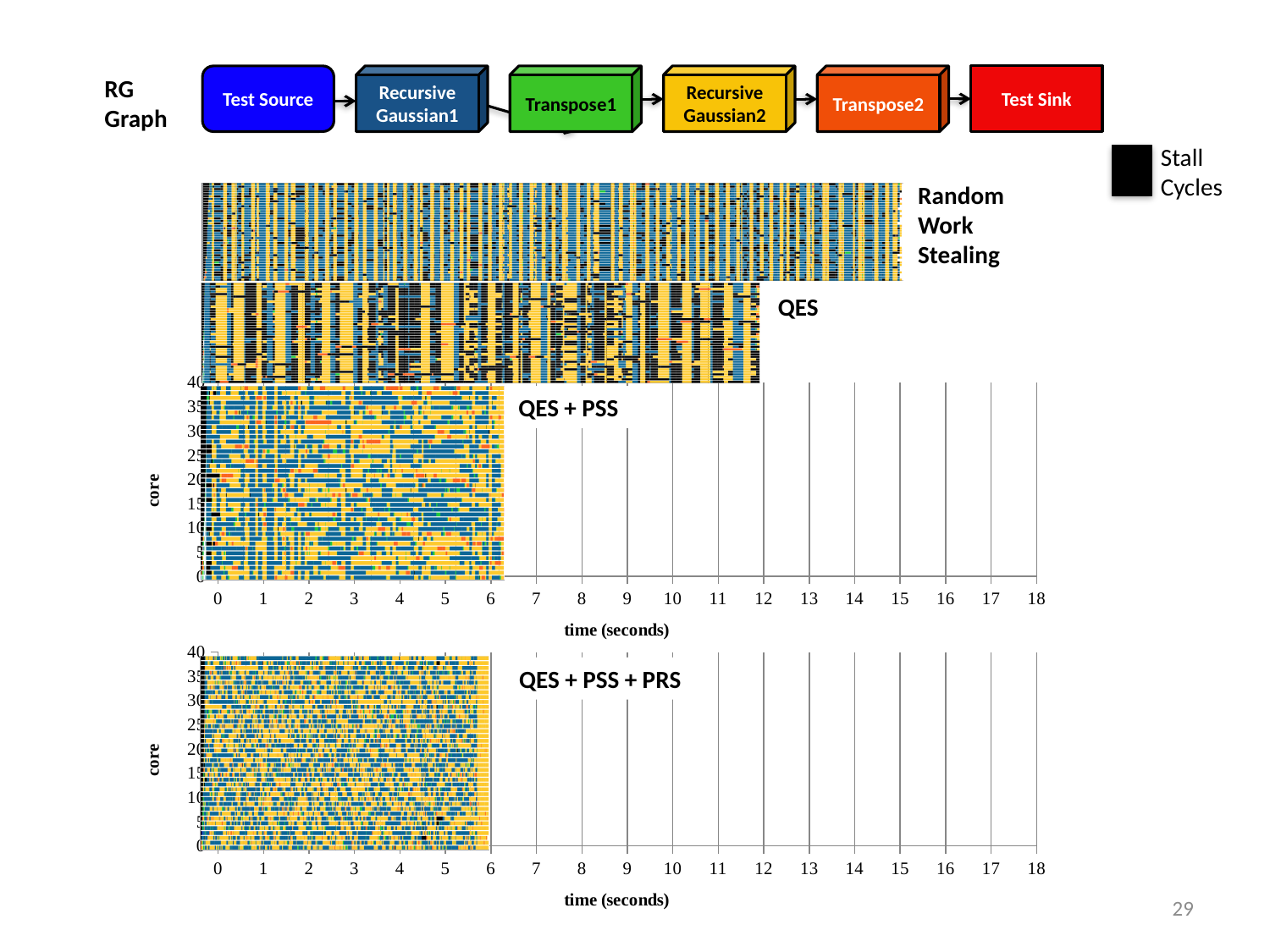
What is the label of the x axis on the timeline charts? time (seconds) Is the finishing time of Random Work Stealing greater or less than 14 seconds? greater What is the highest tick value shown on the x axis of the QES + PSS chart? 18 How many scheduling strategies are shown as timeline charts on the slide? 4 Which takes longer to finish, QES or QES + PSS? QES What is the highest tick value shown on the y axis (core) of the QES + PSS + PRS chart? 40 Which takes longer to finish, Random Work Stealing or QES? Random Work Stealing What does the black colour in the legend represent? Stall Cycles Which scheduling strategy has the longest run time on the time axis? Random Work Stealing Is the finishing time of QES + PSS greater or less than 7 seconds? less Is the finishing time of QES greater or less than 10 seconds? greater